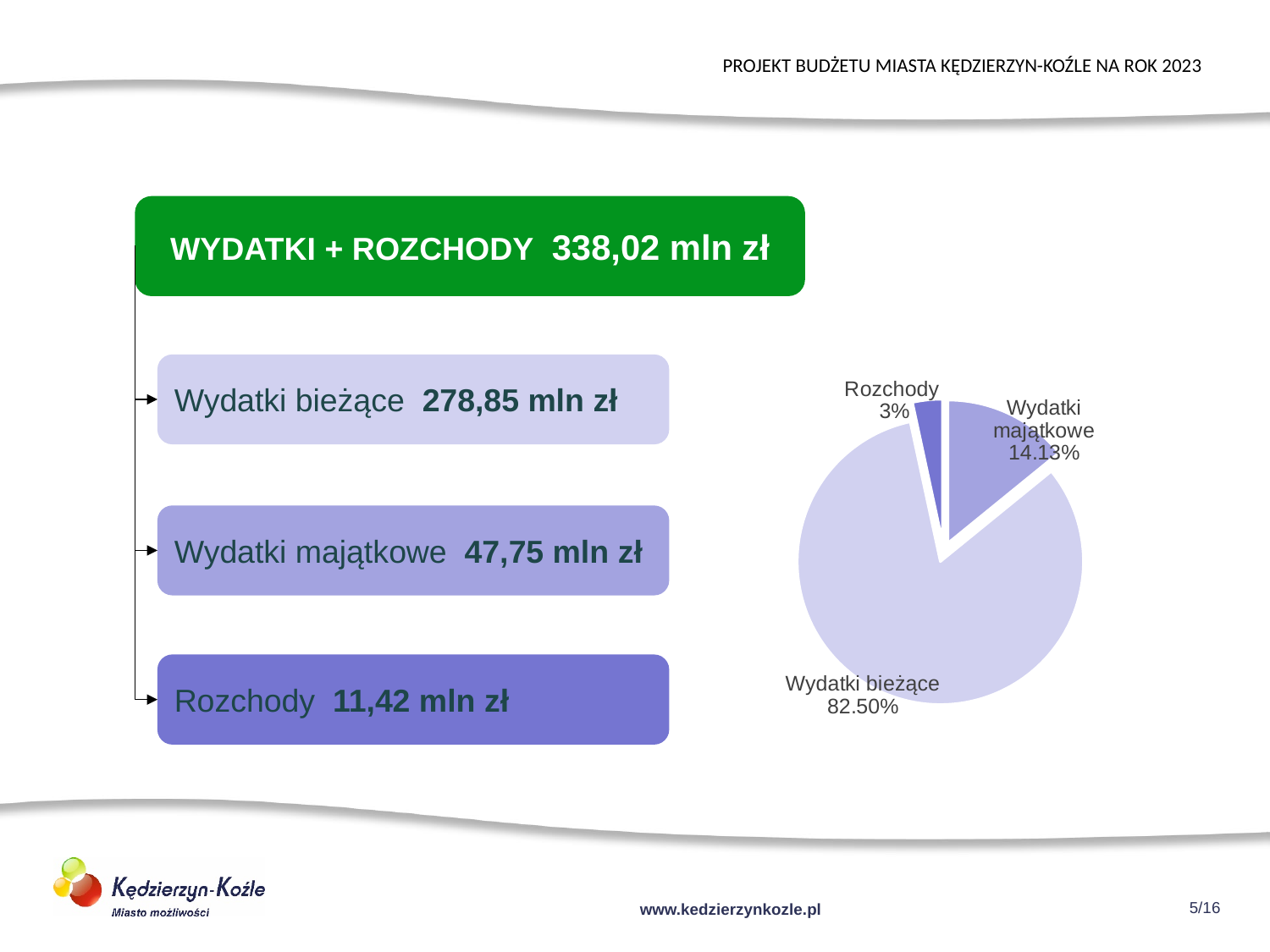
What type of chart is shown on the slide? pie chart What share of the pie does Wydatki majątkowe represent? 14.13% Which slice of the pie chart is drawn in the darkest shade of purple? Rozchody What is the difference in percentage points between the Wydatki majątkowe and Rozchody slices? 11.13 What share of the pie does Rozchody represent? 3% Which is larger in the pie chart, Wydatki majątkowe or Rozchody? Wydatki majątkowe Which slice of the pie chart is the largest? Wydatki bieżące What share of the pie does Wydatki bieżące represent? 82.50% Is the share for Wydatki bieżące greater or less than 50%? greater What is the difference in percentage points between the Wydatki bieżące and Wydatki majątkowe slices? 68.37 How many slices does the pie chart have? 3 Which slice of the pie chart is the smallest? Rozchody